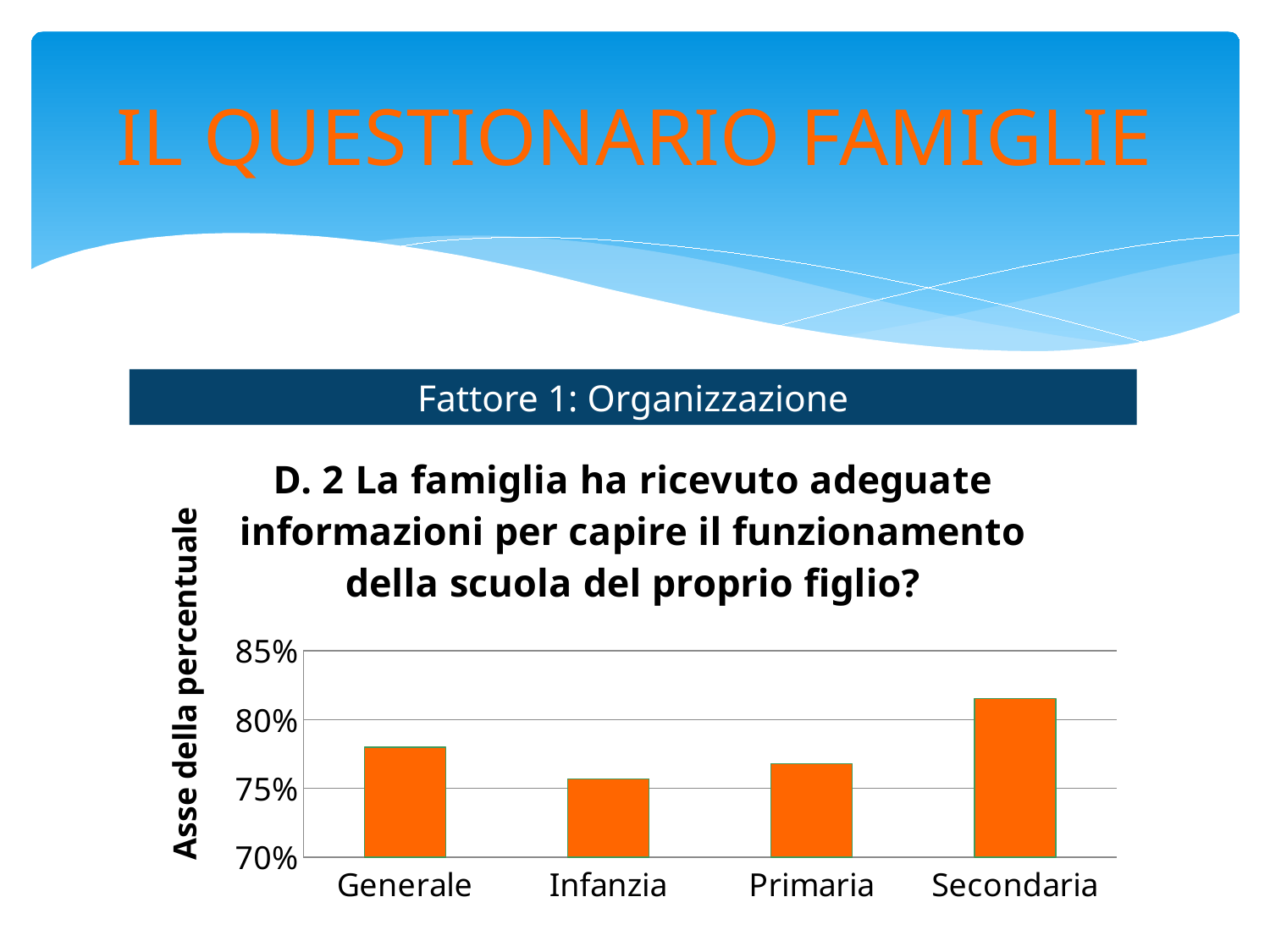
Which category has the highest value in the chart? Secondaria How many categories are shown on the x axis of the chart? 4 Is the value for Primaria greater or less than 80%? less What kind of chart is shown on the slide? bar chart Is the value for Secondaria greater or less than 80%? greater Which category has the lowest value in the chart? Infanzia Is the value for Infanzia greater or less than 80%? less Which is larger, the value for Generale or the value for Infanzia? Generale What is the label of the vertical axis of the chart? Asse della percentuale Which is larger, the value for Secondaria or the value for Generale? Secondaria